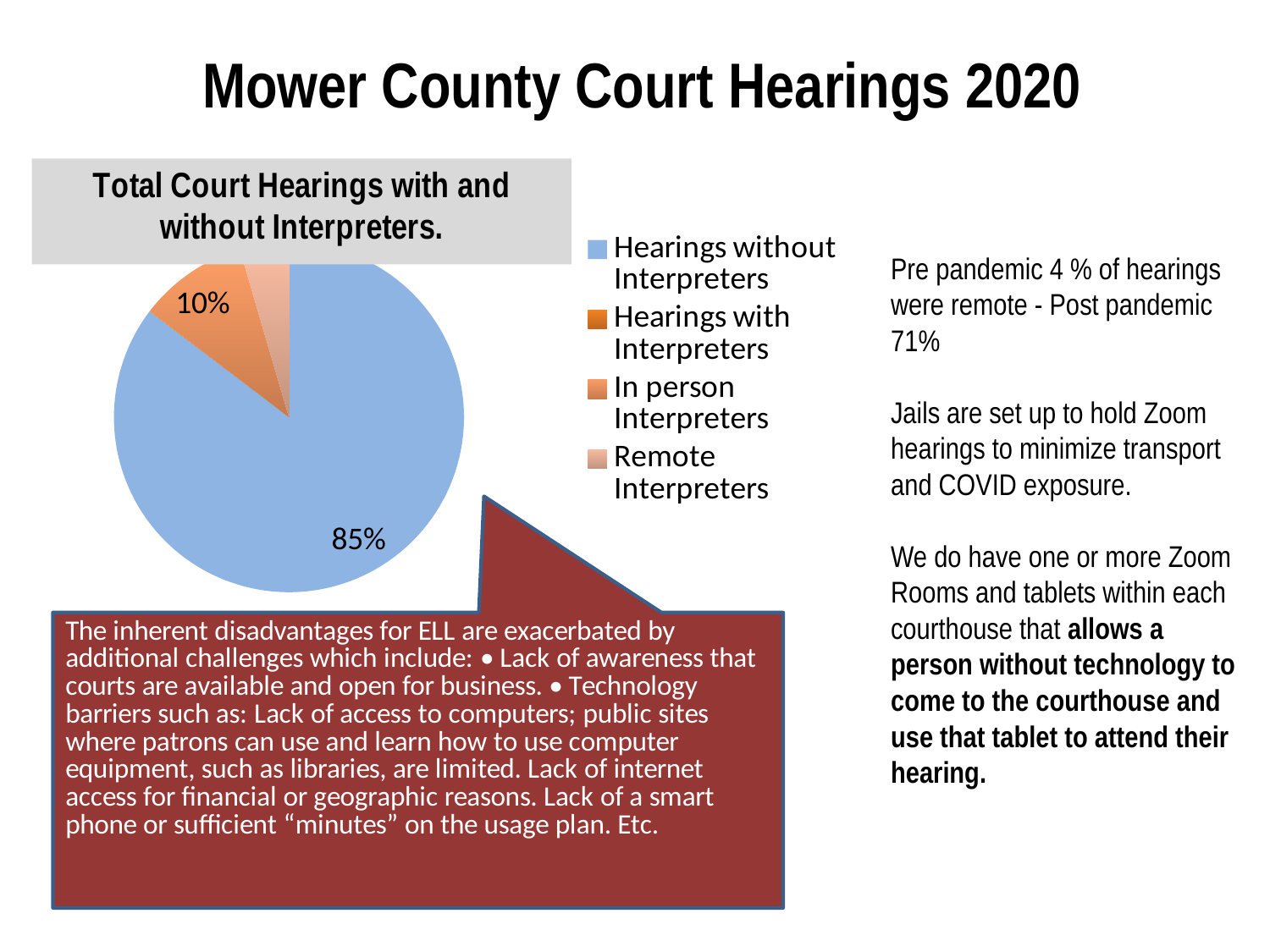
What is the value printed on the second-largest slice of the pie? 10% What colour is the slice for Hearings without Interpreters? blue Which is larger: the slice for Hearings without Interpreters or the slice for Remote Interpreters? Hearings without Interpreters What is the difference between the slice labeled 85% and the slice labeled 10%? 75% How many data labels are printed on the pie chart? 2 What kind of chart is shown on the slide? pie chart How many entries does the chart legend list? 4 Is the share for Hearings without Interpreters greater or less than 50%? greater What is the title of the chart? Total Court Hearings with and without Interpreters. What percentage of the pie is Hearings without Interpreters? 85% Which category has the largest slice of the pie? Hearings without Interpreters